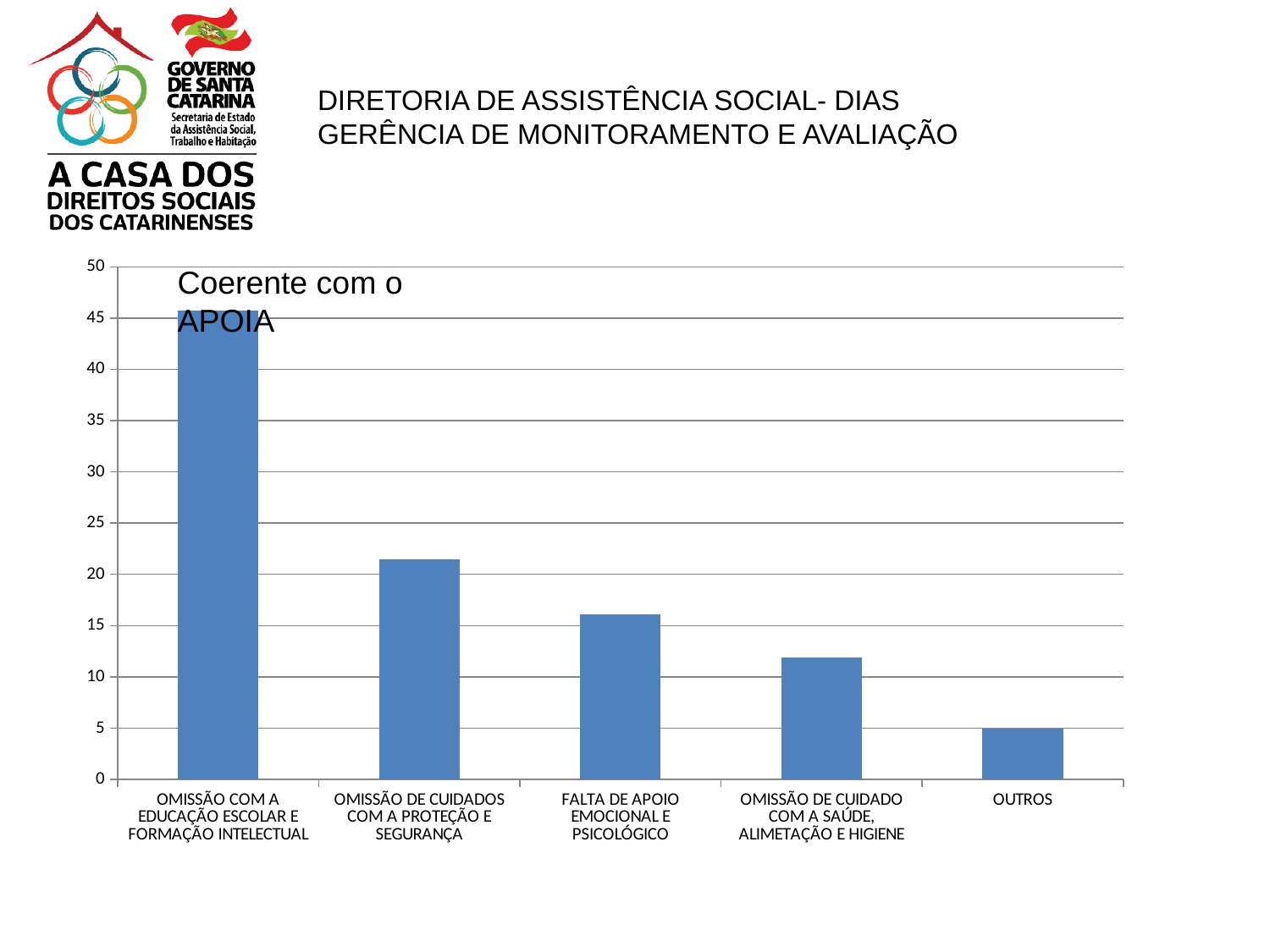
How many categories are shown on the x axis of the chart? 5 Is the value for FALTA DE APOIO EMOCIONAL E PSICOLÓGICO greater or less than 15? greater Which category has the lowest bar in the chart? OUTROS Is the value for OUTROS greater or less than 10? less Do the bar values rise or fall from left to right along the x axis? fall Is the value for OMISSÃO DE CUIDADO COM A SAÚDE, ALIMETAÇÃO E HIGIENE greater or less than 15? less Which is larger: the value for OMISSÃO DE CUIDADOS COM A PROTEÇÃO E SEGURANÇA or the value for FALTA DE APOIO EMOCIONAL E PSICOLÓGICO? OMISSÃO DE CUIDADOS COM A PROTEÇÃO E SEGURANÇA What is the maximum value shown on the vertical axis of the chart? 50 Which category has the highest bar in the chart? OMISSÃO COM A EDUCAÇÃO ESCOLAR E FORMAÇÃO INTELECTUAL What kind of chart is shown on the slide? bar chart